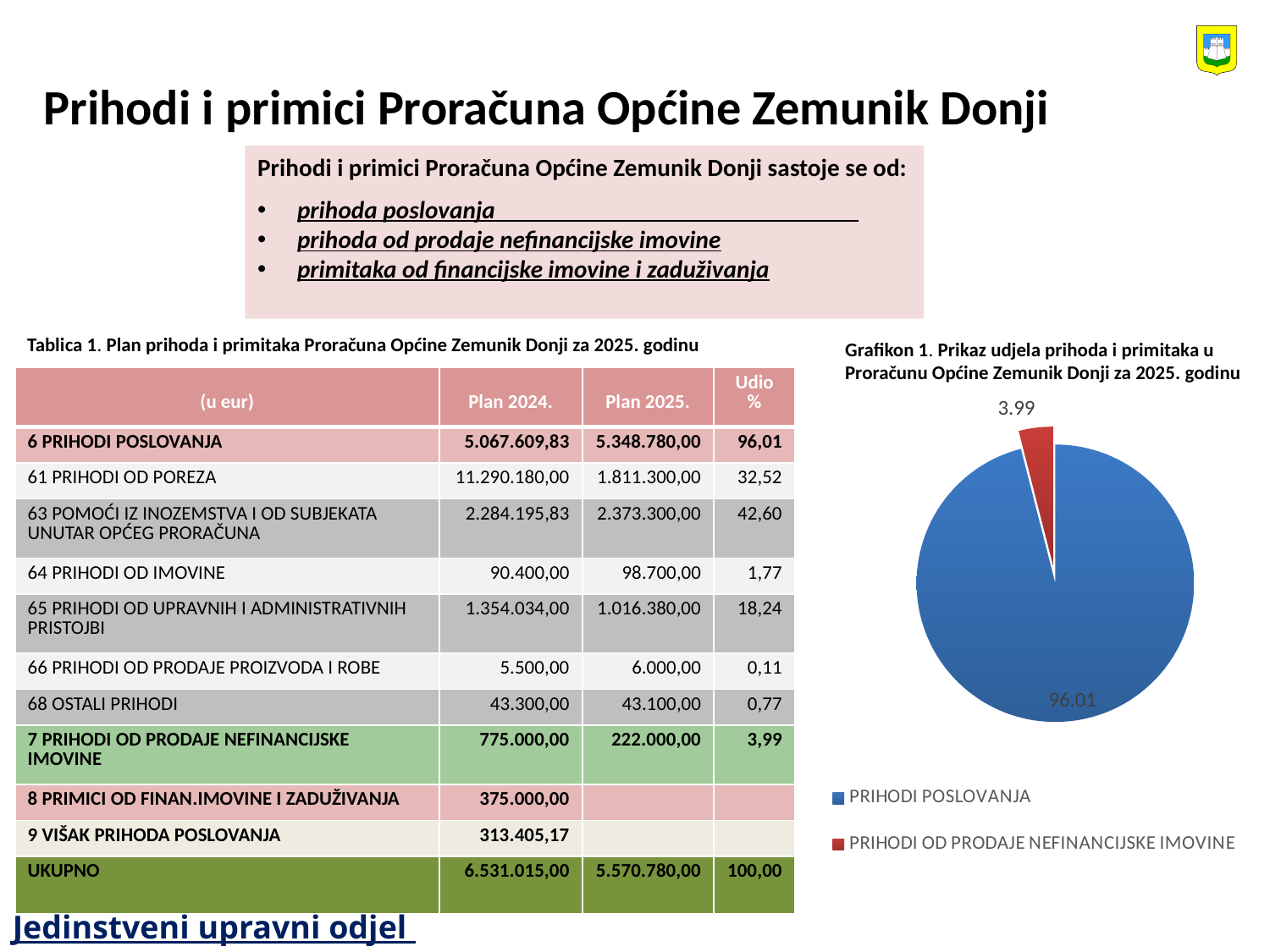
Which is larger in the pie chart: PRIHODI POSLOVANJA or PRIHODI OD PRODAJE NEFINANCIJSKE IMOVINE? PRIHODI POSLOVANJA What is the title of the pie chart? Grafikon 1. Prikaz udjela prihoda i primitaka u Proračunu Općine Zemunik Donji za 2025. godinu What is the difference between the values for PRIHODI POSLOVANJA and PRIHODI OD PRODAJE NEFINANCIJSKE IMOVINE in the pie chart? 92.02 Which category has the largest slice in the pie chart? PRIHODI POSLOVANJA Which category has the smallest slice in the pie chart? PRIHODI OD PRODAJE NEFINANCIJSKE IMOVINE What kind of chart is shown on the slide? pie chart What colour is the slice for PRIHODI POSLOVANJA in the pie chart? blue How many slices does the pie chart have? 2 What is the value shown for PRIHODI OD PRODAJE NEFINANCIJSKE IMOVINE in the pie chart? 3.99 What is the value shown for PRIHODI POSLOVANJA in the pie chart? 96.01 How many entries does the legend of the pie chart list? 2